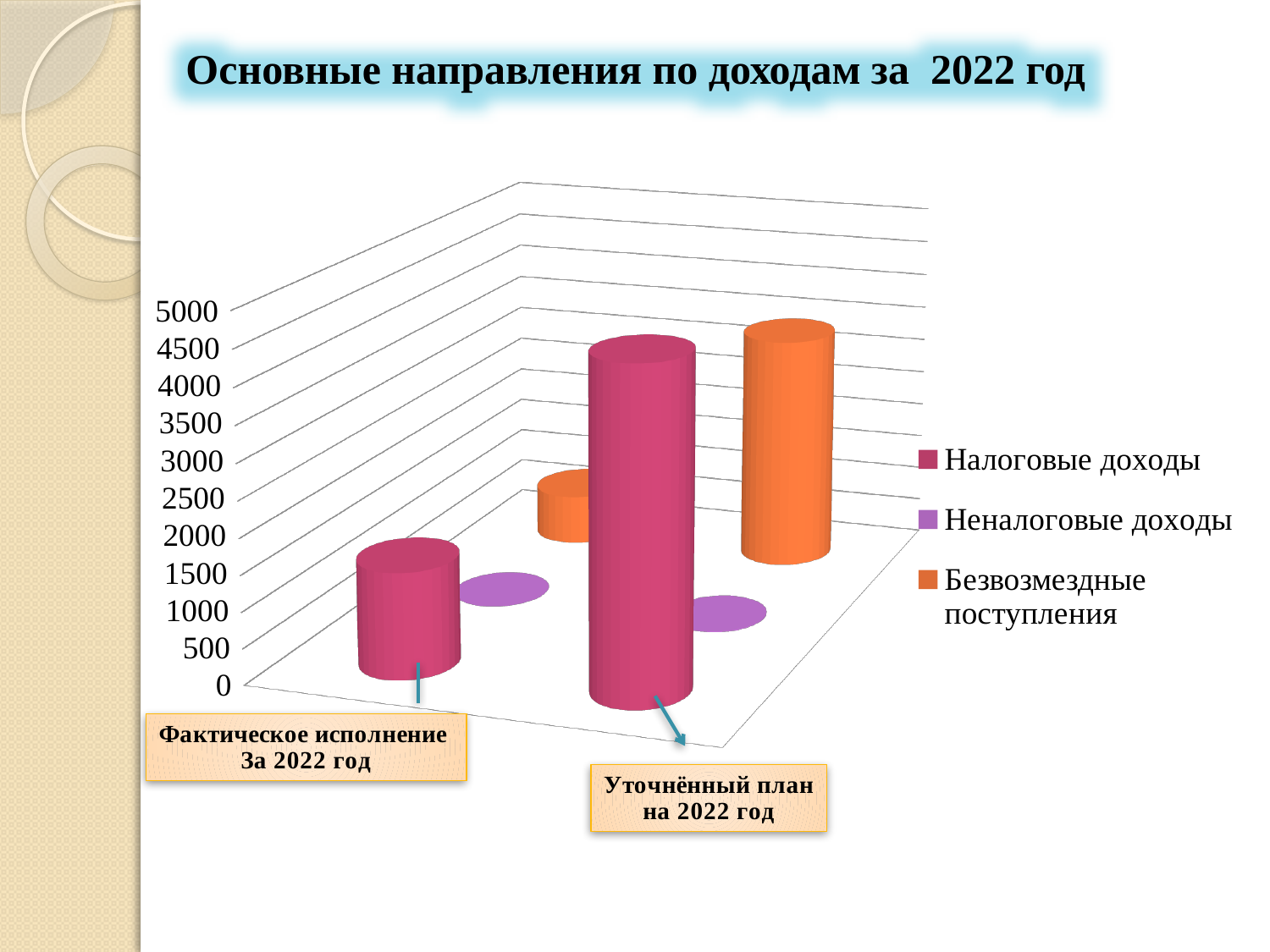
What is the title of the chart? Основные направления по доходам за 2022 год Which is larger for Безвозмездные поступления: Фактическое исполнение За 2022 год or Уточнённый план на 2022 год? Уточнённый план на 2022 год Is the value of Налоговые доходы for Уточнённый план на 2022 год greater or less than 3000? greater How many categories are shown on the x axis of the chart? 2 Is the value of Налоговые доходы for Фактическое исполнение За 2022 год greater or less than 3000? less How many series does the legend list? 3 Which is larger for Налоговые доходы: Фактическое исполнение За 2022 год or Уточнённый план на 2022 год? Уточнённый план на 2022 год What type of chart is shown on the slide? bar chart Which series has the lowest value for Уточнённый план на 2022 год? Неналоговые доходы Which series has the lowest value for Фактическое исполнение За 2022 год? Неналоговые доходы Is the value of Неналоговые доходы for Фактическое исполнение За 2022 год greater or less than 500? less Which series is shown in orange in the legend? Безвозмездные поступления